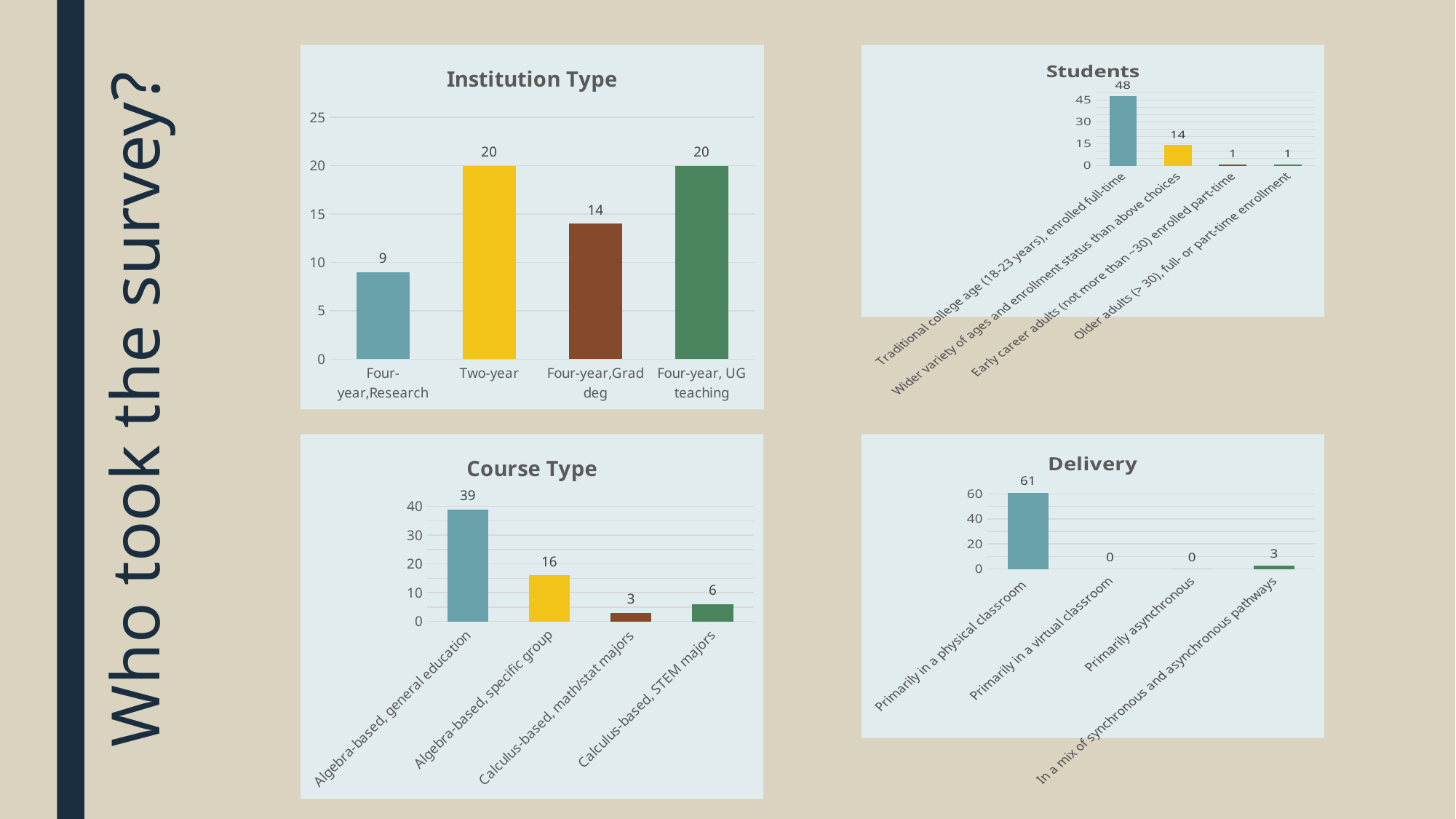
In the Institution Type chart, what is the value for Two-year? 20 In the Institution Type chart, which category has the lowest value? Four-year,Research In the Students chart, which category has the highest value? Traditional college age (18-23 years), enrolled full-time In the Course Type chart, what is the difference between Algebra-based, general education and Algebra-based, specific group? 23 In the Delivery chart, what is the value for Primarily in a physical classroom? 61 In the Course Type chart, which is larger: Algebra-based, specific group or Calculus-based, math/stat majors? Algebra-based, specific group What kind of chart is the Delivery chart? Bar chart In the Institution Type chart, what is the difference between Four-year, UG teaching and Four-year,Grad deg? 6 In the Students chart, what is the value for Wider variety of ages and enrollment status than above choices? 14 How many categories does the Students chart show? 4 In the Delivery chart, what is the value for In a mix of synchronous and asynchronous pathways? 3 In the Course Type chart, what is the value for Calculus-based, STEM majors? 6